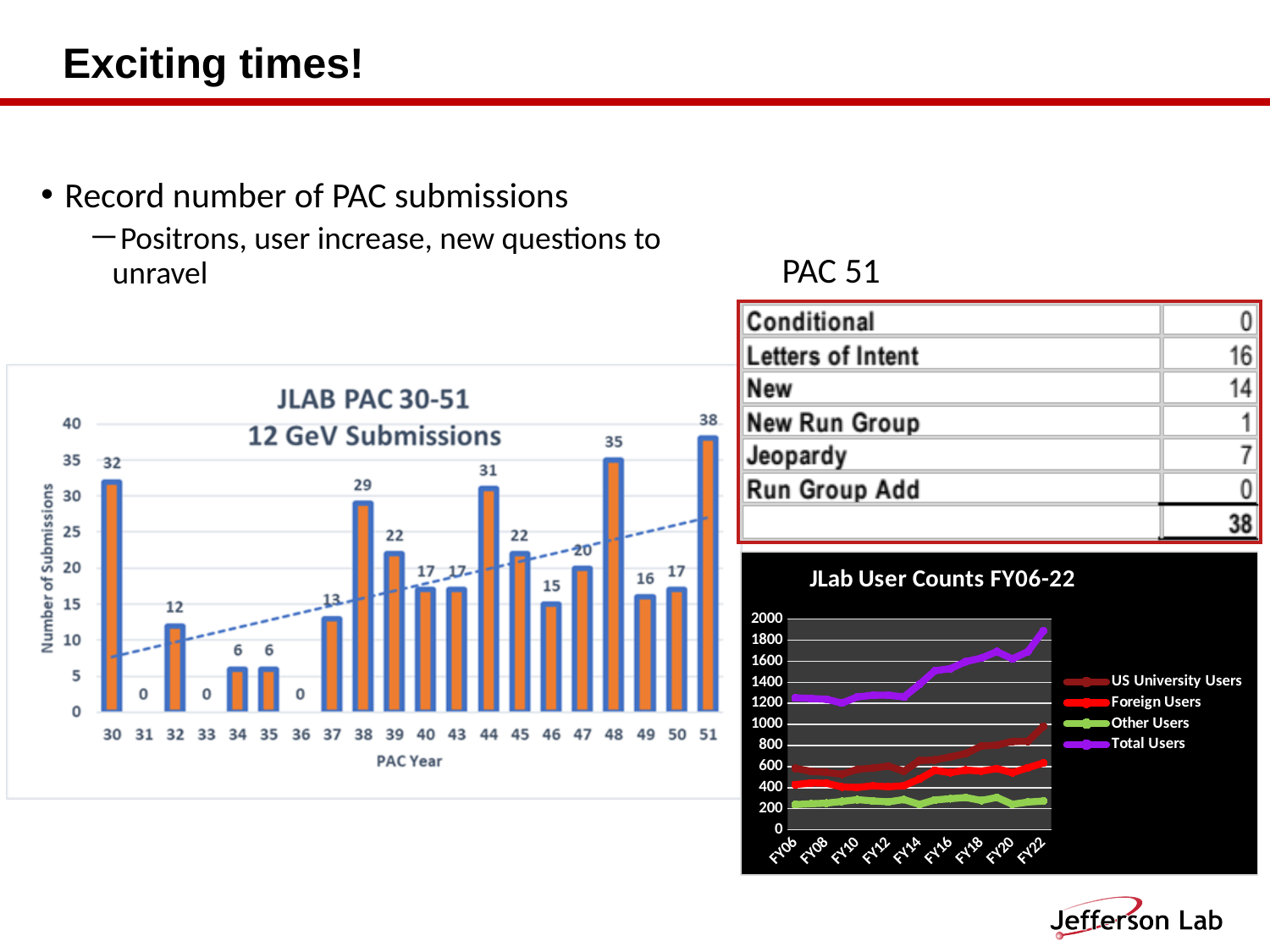
In the JLAB PAC 30-51 12 GeV Submissions chart, how many submissions were there for PAC 38? 29 In the JLAB PAC 30-51 12 GeV Submissions chart, how many PAC years are shown on the x axis? 20 In the JLab User Counts FY06-22 chart, is the value for Total Users at FY22 greater or less than 1800? greater In the JLab User Counts FY06-22 chart, which series is shown in purple? Total Users In the JLAB PAC 30-51 12 GeV Submissions chart, which PAC year has the highest number of submissions? 51 In the JLAB PAC 30-51 12 GeV Submissions chart, which has more submissions, PAC 30 or PAC 39? PAC 30 In the JLAB PAC 30-51 12 GeV Submissions chart, what is the label of the y axis? Number of Submissions In the JLAB PAC 30-51 12 GeV Submissions chart, what is the difference in submissions between PAC 48 and PAC 44? 4 In the JLAB PAC 30-51 12 GeV Submissions chart, how many submissions were there for PAC 51? 38 What kind of chart is the JLAB PAC 30-51 12 GeV Submissions chart? Bar chart How many series does the legend of the JLab User Counts FY06-22 chart list? 4 In the JLab User Counts FY06-22 chart, does the Total Users series generally rise or fall from FY06 to FY22? Rise